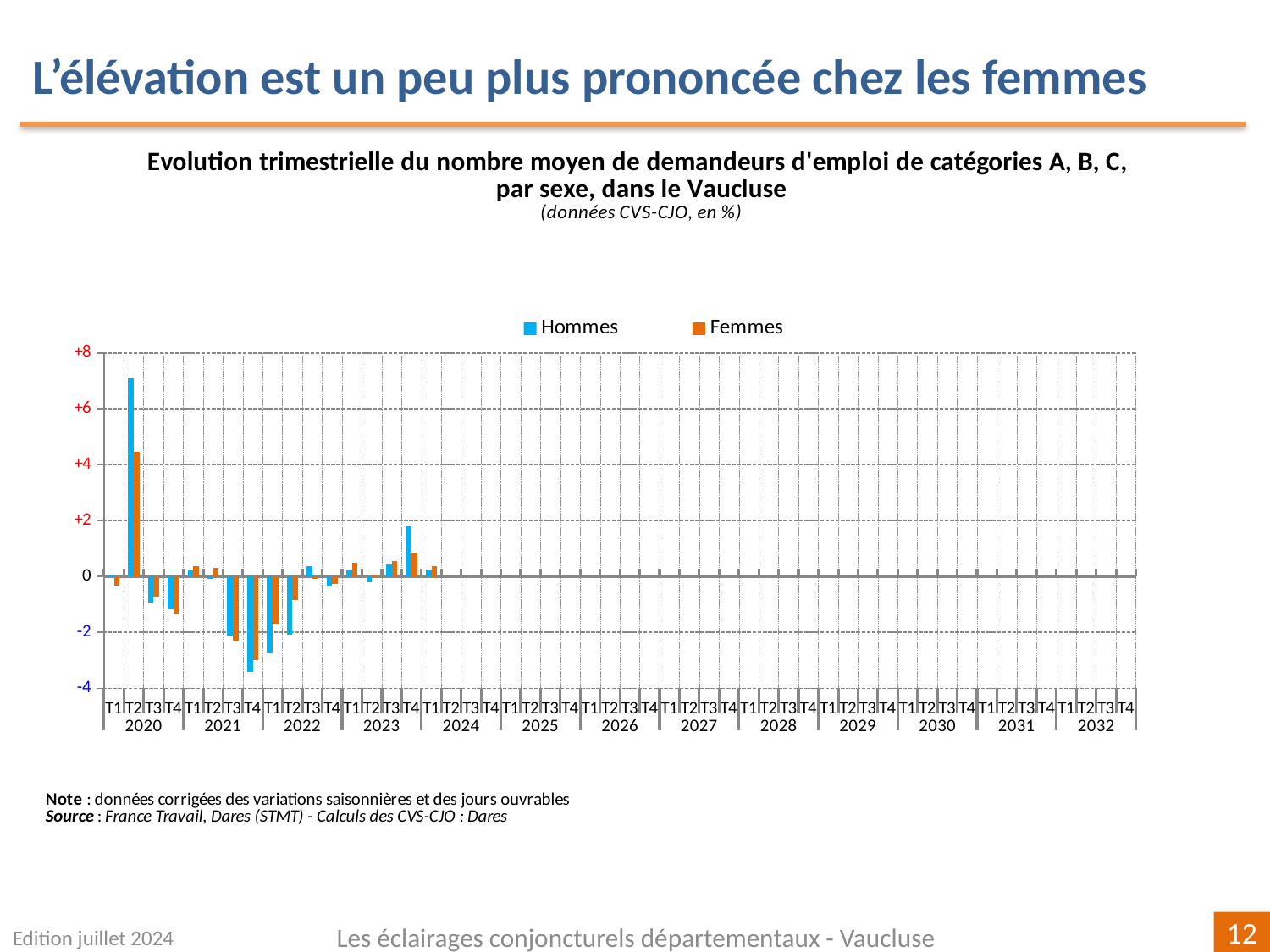
In which quarter does the Hommes series reach its highest value? T2 2020 What kind of chart is shown on the slide? bar chart Is the Femmes value for T4 2021 greater or less than -2? less Is the Hommes value for T4 2021 greater or less than -2? less In T4 2023, which series has the larger value, Hommes or Femmes? Hommes Which colour represents the Femmes series? orange What are the two series named in the legend? Hommes and Femmes Is the Femmes value for T2 2020 greater or less than +4? greater How many series does the legend list? 2 In T2 2020, which series has the larger value, Hommes or Femmes? Hommes In which quarter does the Hommes series reach its lowest value? T4 2021